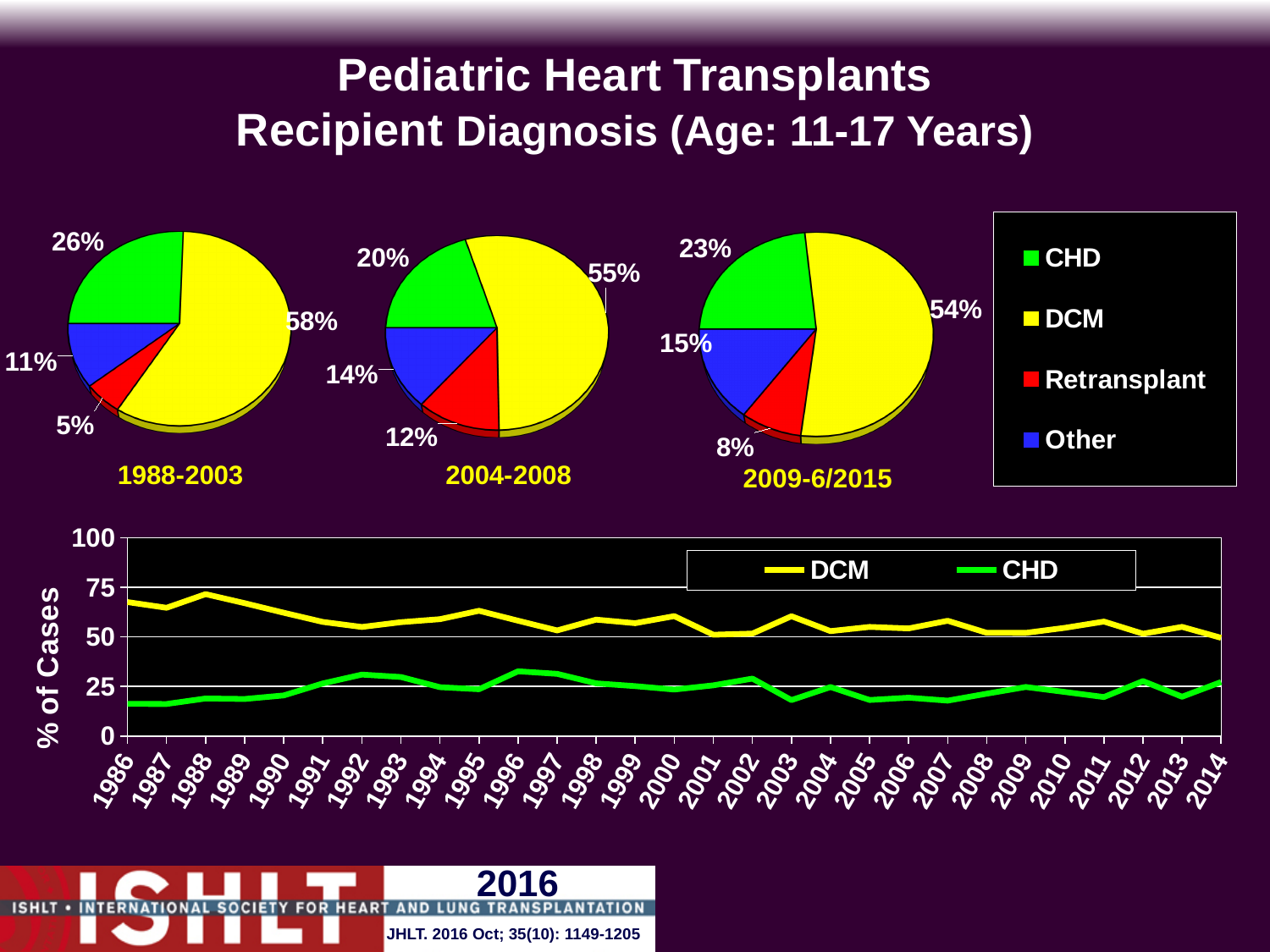
In the bottom line chart, is the DCM value for 1988 greater or less than 50? greater In the 2004-2008 pie chart, what share of cases is Retransplant? 12% In the 2009-6/2015 pie chart, which diagnosis has the largest share? DCM In the 1988-2003 pie chart, which diagnosis has the smallest share? Retransplant Comparing the 1988-2003 and 2009-6/2015 pie charts, which period has the larger Retransplant share? 2009-6/2015 In the bottom line chart, which series is higher in 2014, DCM or CHD? DCM In the 2004-2008 pie chart, what is the difference between the CHD share and the Other share? 6% In the bottom line chart, is the CHD value for 1986 greater or less than 25? less How many series does the legend of the bottom line chart list? 2 What kind of chart is the bottom chart showing % of Cases by year? Line chart In the 1988-2003 pie chart, what share of cases is DCM? 58% In the 2009-6/2015 pie chart, what share of cases is Other? 15%